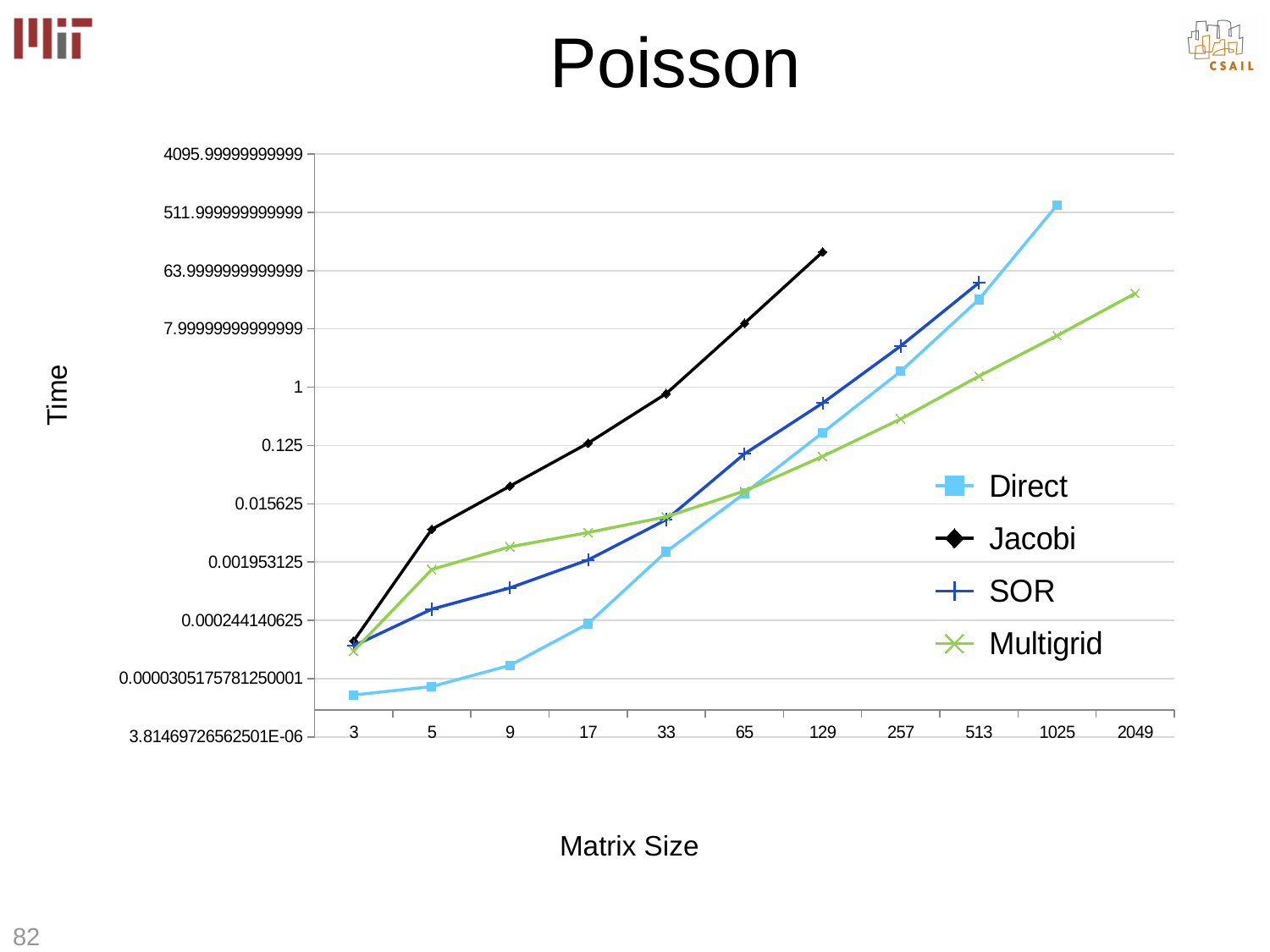
Which series has the highest time at matrix size 65? Jacobi What is the label of the x axis? Matrix Size Which series is the only one plotted at matrix size 2049? Multigrid At matrix size 33, which is larger, the time for Jacobi or the time for Direct? Jacobi How many matrix sizes are marked on the x axis? 11 What kind of chart is shown on the slide? line chart Does the Jacobi series rise or fall as matrix size increases? rise Is the time for SOR at matrix size 129 greater or less than 1? less At matrix size 257, which is larger, the time for SOR or the time for Multigrid? SOR Which series has the lowest time at matrix size 17? Direct How many series does the legend list? 4 Is the time for Jacobi at matrix size 129 greater or less than 63.9999999999999? greater